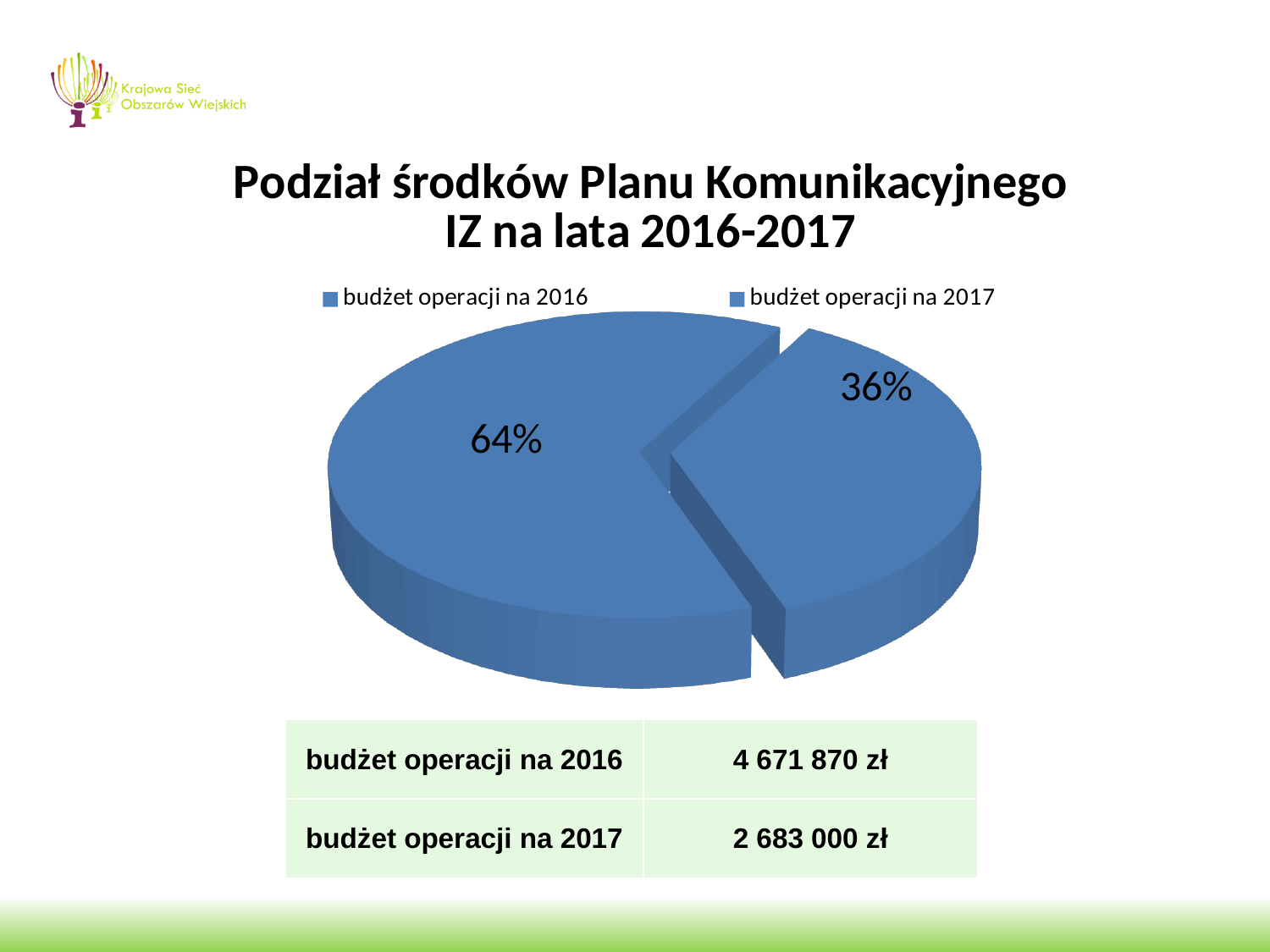
What is the value shown for 'budżet operacji na 2016' in the table below the chart? 4 671 870 zł Which category has the largest slice of the pie? budżet operacji na 2016 What is the value shown for 'budżet operacji na 2017' in the table below the chart? 2 683 000 zł What kind of chart is shown on the slide? pie chart How many entries does the legend list? 2 Which category has the smallest slice of the pie? budżet operacji na 2017 What share of the pie does 'budżet operacji na 2016' represent? 64% Which is larger, the budget for 2016 or the budget for 2017? budżet operacji na 2016 How many slices does the pie chart have? 2 What share of the pie does 'budżet operacji na 2017' represent? 36% What is the difference between the 2016 budget and the 2017 budget shown in the table? 1 988 870 zł What is the title of the chart on the slide? Podział środków Planu Komunikacyjnego IZ na lata 2016-2017